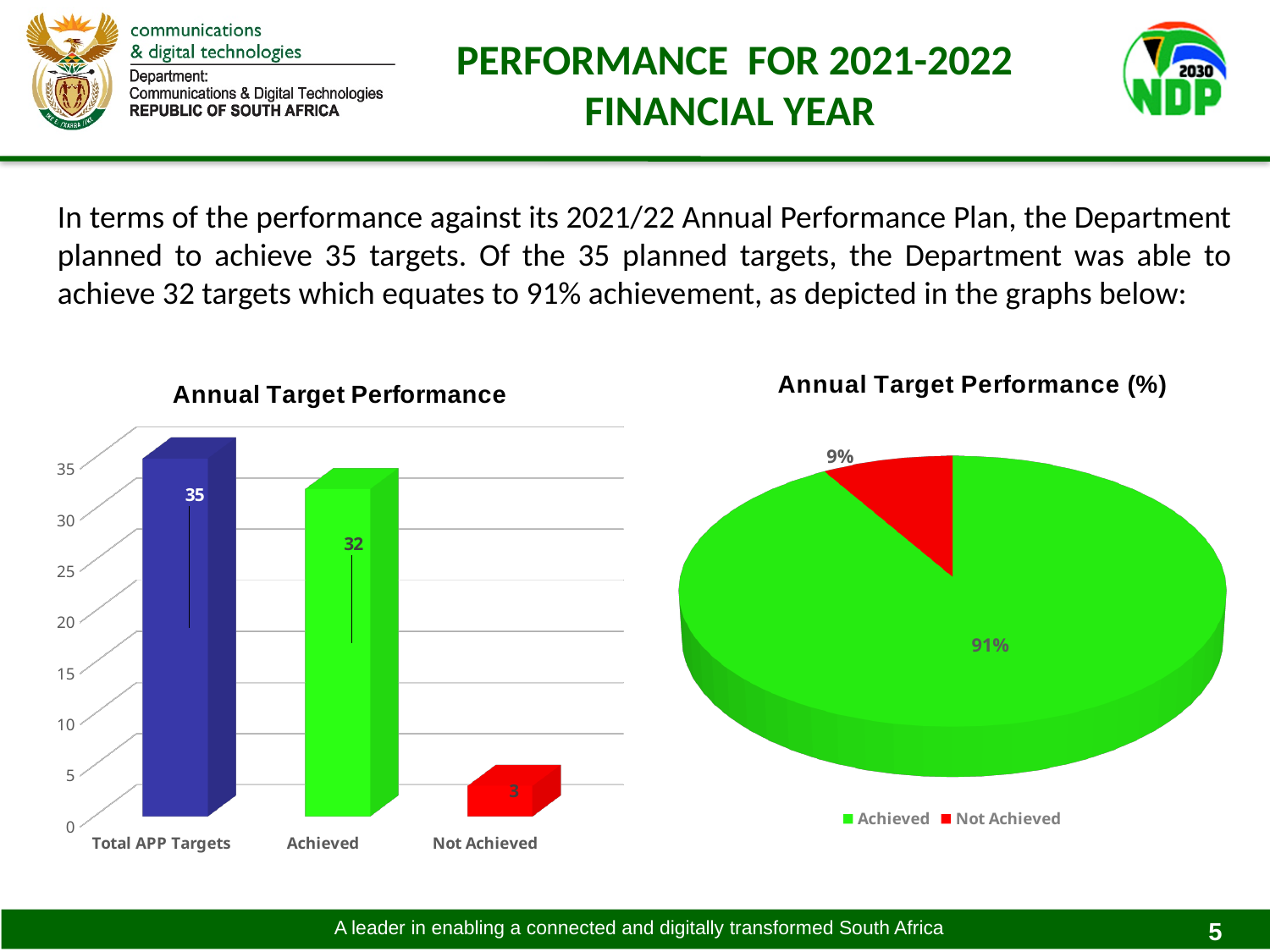
In the 'Annual Target Performance' chart, what is the difference between Total APP Targets and Achieved? 3 In the 'Annual Target Performance (%)' chart, what share does Not Achieved have? 9% In the 'Annual Target Performance' chart, what is the value for Achieved? 32 What kind of chart is the 'Annual Target Performance (%)' chart on the right? Pie chart In the 'Annual Target Performance' chart, what is the value for Total APP Targets? 35 What kind of chart is the 'Annual Target Performance' chart on the left? Bar chart In the 'Annual Target Performance' chart, how many categories are shown? 3 In the 'Annual Target Performance' chart, which category has the highest value? Total APP Targets In the 'Annual Target Performance (%)' chart, what share does Achieved have? 91% In the 'Annual Target Performance' chart, which category has the lowest value? Not Achieved In the 'Annual Target Performance (%)' chart, how many entries does the legend list? 2 In the 'Annual Target Performance' chart, what is the value for Not Achieved? 3